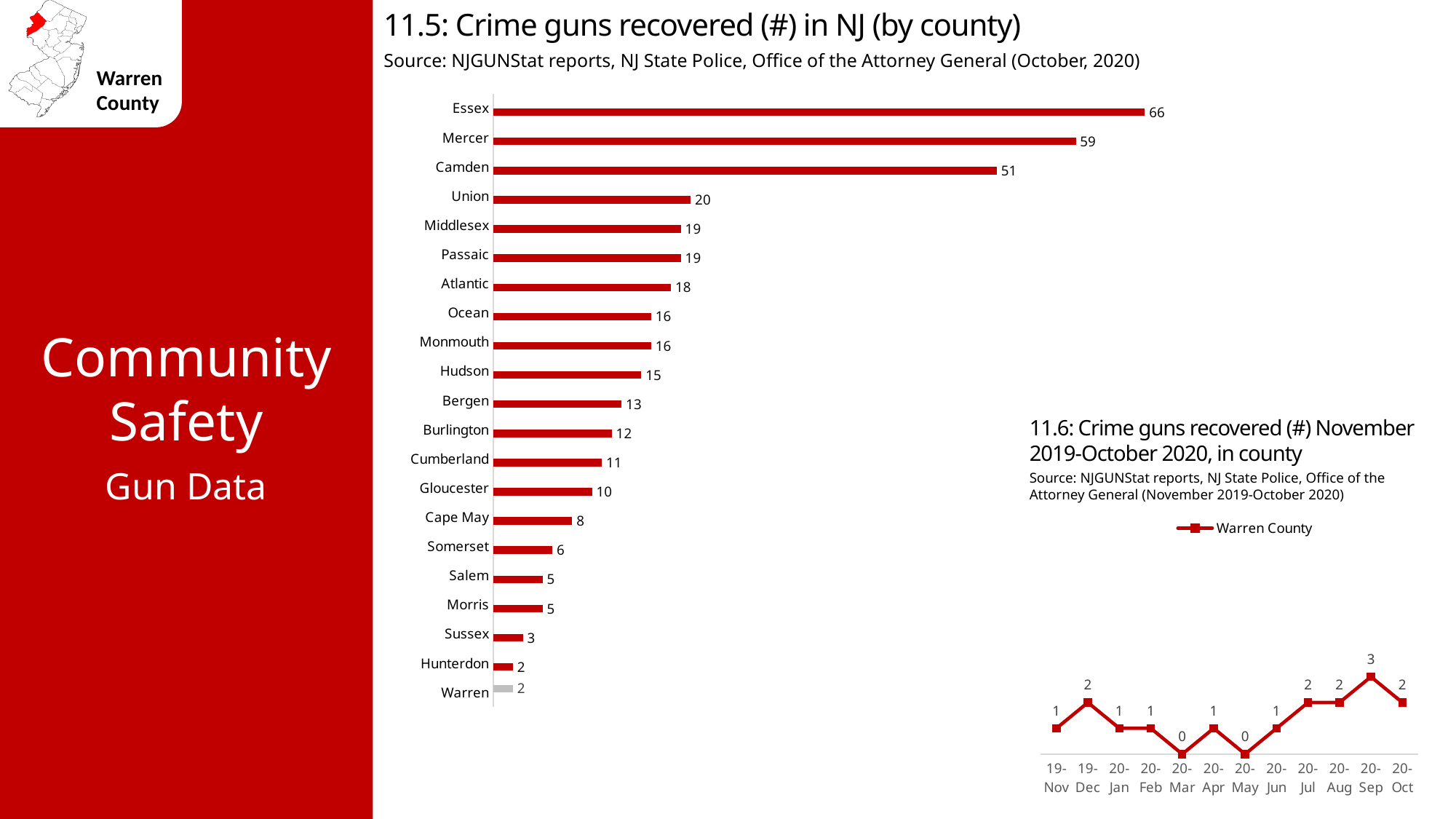
In the chart '11.6: Crime guns recovered (#) November 2019-October 2020, in county', how many data points are plotted? 12 What kind of chart is '11.6: Crime guns recovered (#) November 2019-October 2020, in county'? Line chart In the chart '11.5: Crime guns recovered (#) in NJ (by county)', how many crime guns were recovered in Essex? 66 In the chart '11.6: Crime guns recovered (#) November 2019-October 2020, in county', what is the value for 20-Sep? 3 In the chart '11.5: Crime guns recovered (#) in NJ (by county)', which county has the highest number of crime guns recovered? Essex In the chart '11.5: Crime guns recovered (#) in NJ (by county)', what is the value for Warren? 2 What kind of chart is '11.5: Crime guns recovered (#) in NJ (by county)'? Bar chart In the chart '11.6: Crime guns recovered (#) November 2019-October 2020, in county', how many series does the legend list? 1 In the chart '11.6: Crime guns recovered (#) November 2019-October 2020, in county', which month has the highest value? 20-Sep In the chart '11.5: Crime guns recovered (#) in NJ (by county)', how many counties are listed? 21 In the chart '11.5: Crime guns recovered (#) in NJ (by county)', which is larger, the value for Union or the value for Hudson? Union In the chart '11.5: Crime guns recovered (#) in NJ (by county)', what is the difference between Mercer and Camden? 8